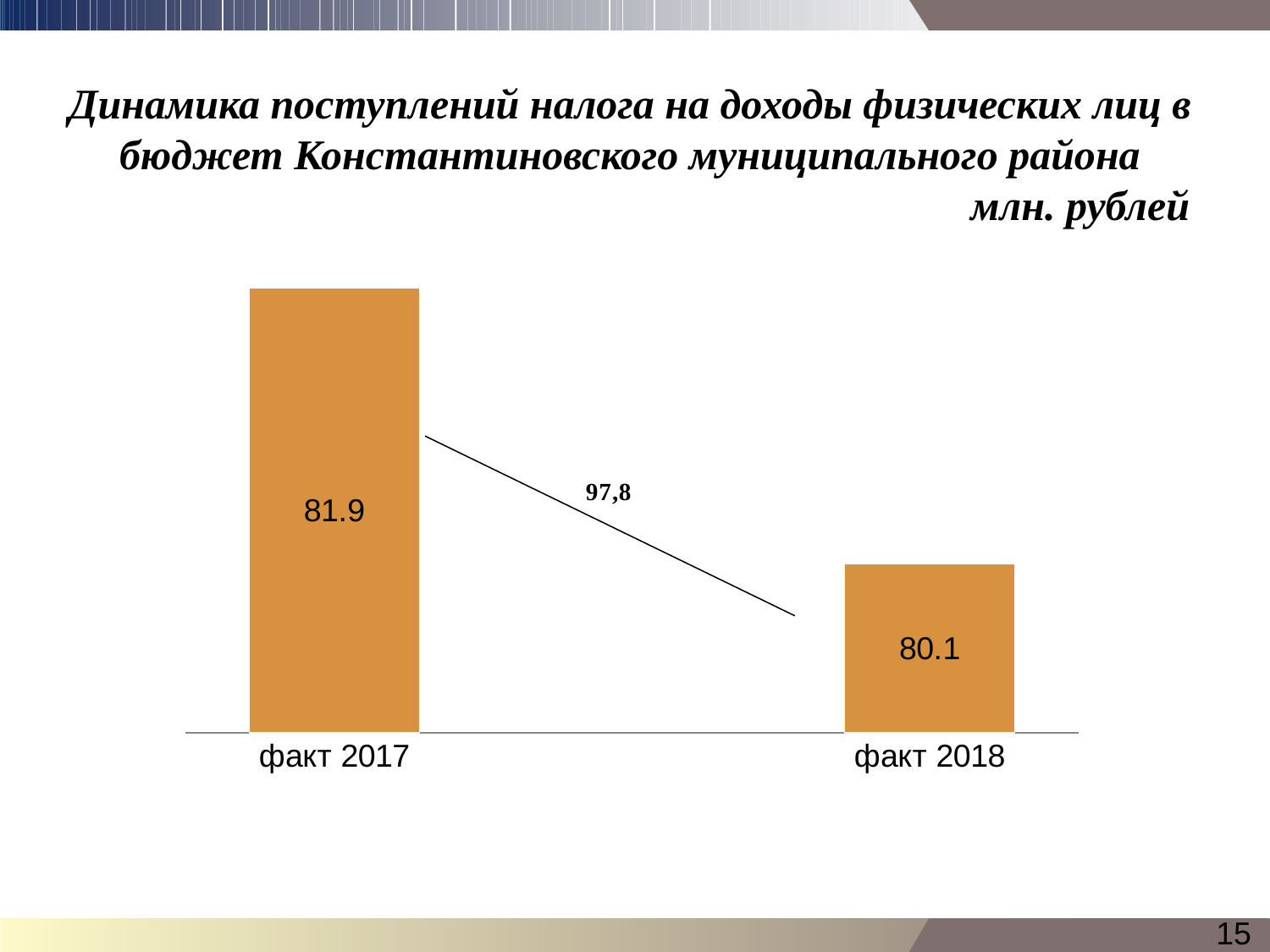
What number is written next to the line connecting the two bars? 97,8 Do the values rise or fall from факт 2017 to факт 2018? fall What kind of chart is shown on the slide? bar chart Which category has the lowest value? факт 2018 Which is larger, the value for факт 2017 or факт 2018? факт 2017 What unit of measurement is stated under the chart title? млн. рублей What is the value for факт 2017? 81.9 Which category has the highest value? факт 2017 What is the value for факт 2018? 80.1 How many categories are shown in the chart? 2 What is the difference between the values for факт 2017 and факт 2018? 1.8